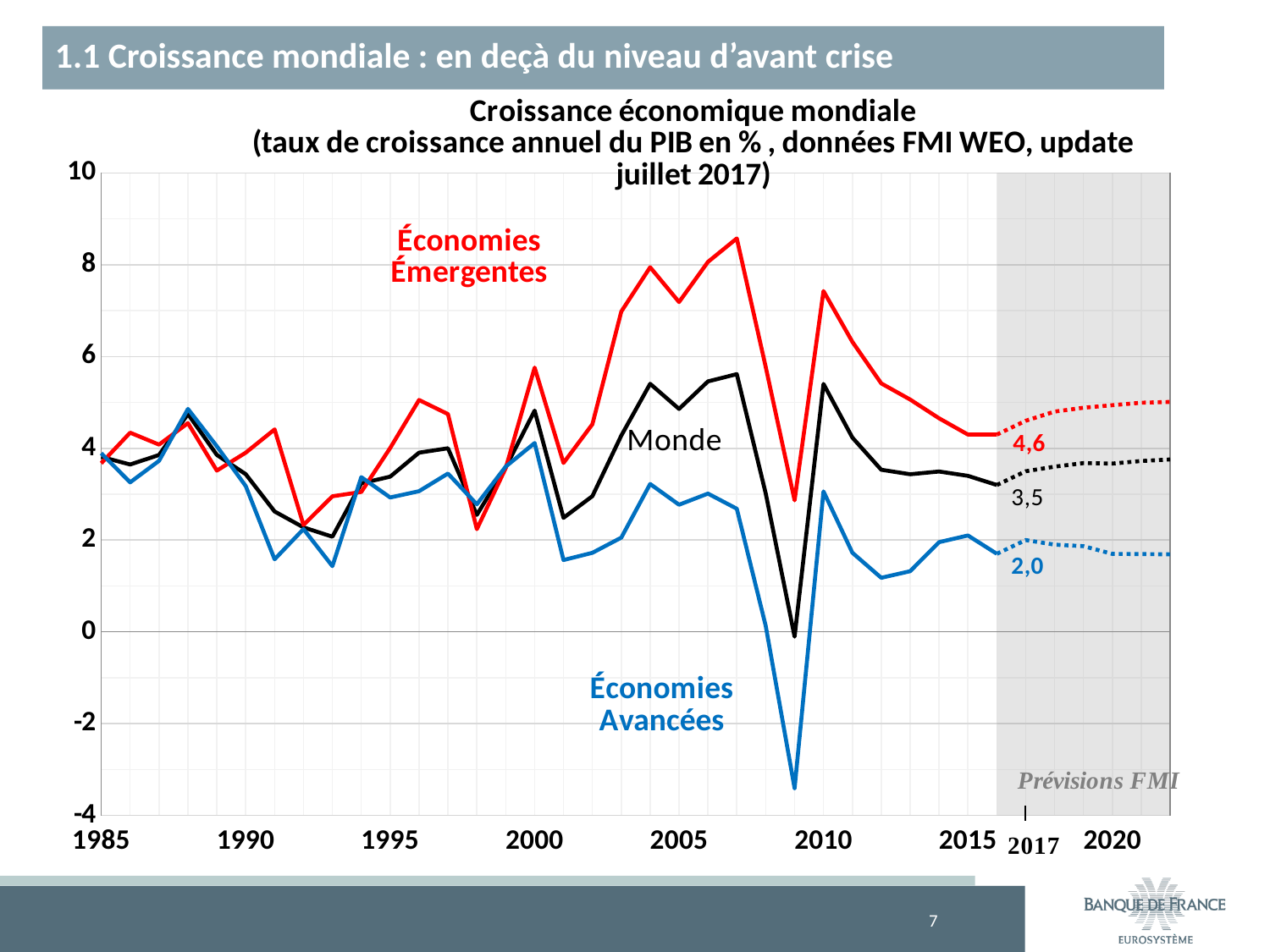
What is the difference between the 2017 labelled values for Économies Émergentes and Économies Avancées? 2,6 What is the 2017 value labelled for Monde? 3,5 Which series has the lowest value in 2009? Économies Avancées What does the label in the shaded area on the right of the chart say? Prévisions FMI Which has the larger labelled 2017 value, Monde or Économies Avancées? Monde Is the value for Économies Émergentes in 2007 greater or less than 8? greater What kind of chart is shown on the slide? line chart What is the 2017 value labelled for Économies Avancées? 2,0 What is the 2017 value labelled for Économies Émergentes? 4,6 Is the value for Économies Avancées in 2009 greater or less than -2? less What is the difference between the 2017 labelled values for Économies Émergentes and Monde? 1,1 How many series are plotted on the chart? 3